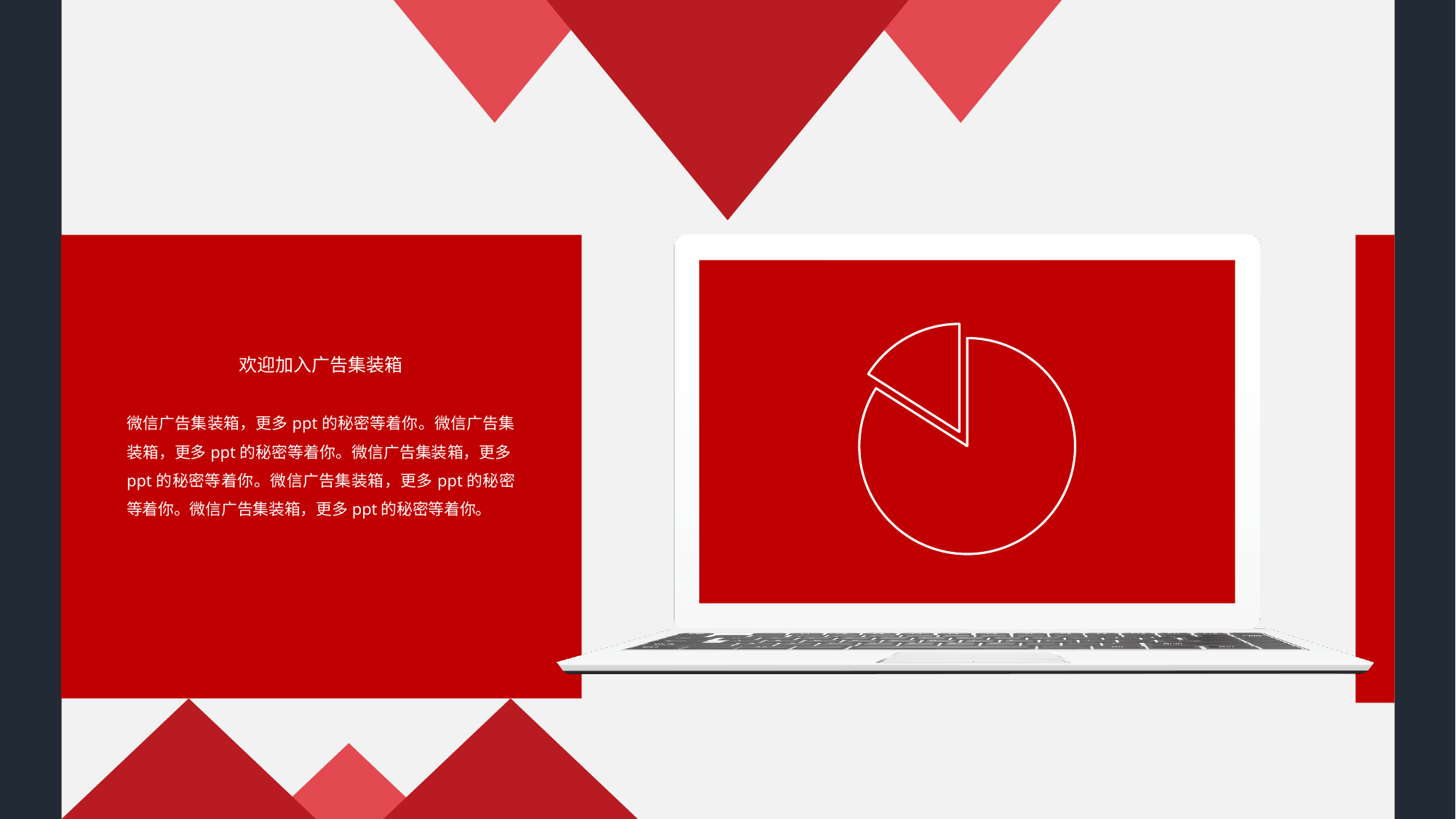
Does the pie chart on the laptop screen show any data labels or a legend? No What kind of chart is shown on the laptop screen? pie chart How many slices does the pie chart on the laptop screen have? 2 Is the slice pulled out from the pie chart larger or smaller than the remaining portion of the pie? smaller What colour is the outline of the pie chart on the laptop screen? white